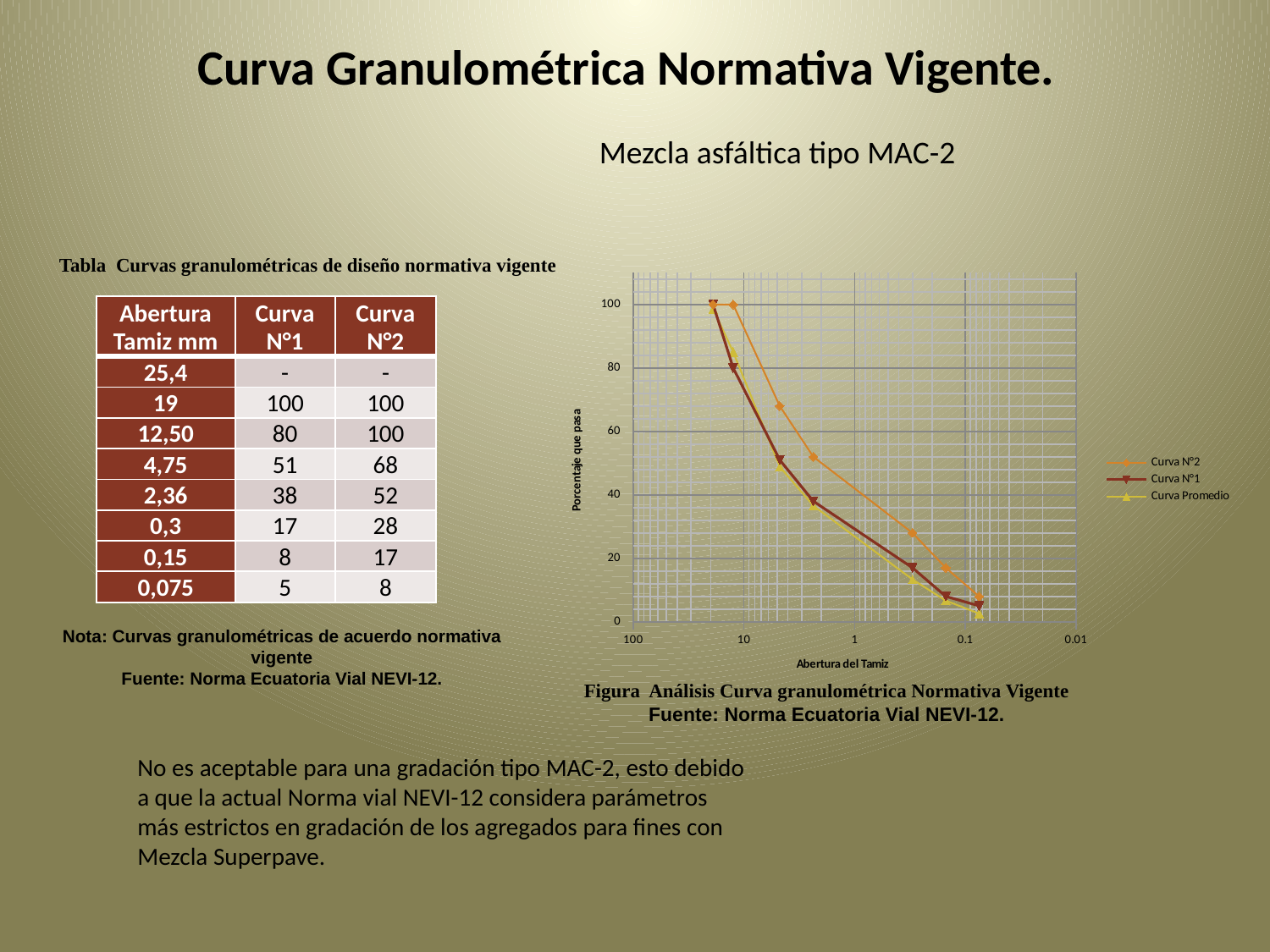
Is the value of Curva N°2 at a sieve opening of 4.75 mm greater or less than 60? greater Do the values of the curves rise or fall as you move from left to right along the x axis? fall What are the names of the series listed in the chart legend? Curva N°2, Curva N°1, Curva Promedio How many series does the chart legend list? 3 Which series lies highest on the chart across the sieve openings? Curva N°2 What is the title of the vertical axis of the chart? Porcentaje que pasa What is the value of Curva N°1 at a sieve opening of 19 mm on the chart? 100 What kind of chart is shown on the slide? line chart At a sieve opening of 4.75 mm, which series has the higher value, Curva N°1 or Curva N°2? Curva N°2 Is the value of Curva N°1 at a sieve opening of 0.15 mm greater or less than 20? less Is the value of Curva N°2 at a sieve opening of 0.3 mm greater or less than 20? greater What is the value of Curva N°1 at a sieve opening of 12.5 mm on the chart? 80